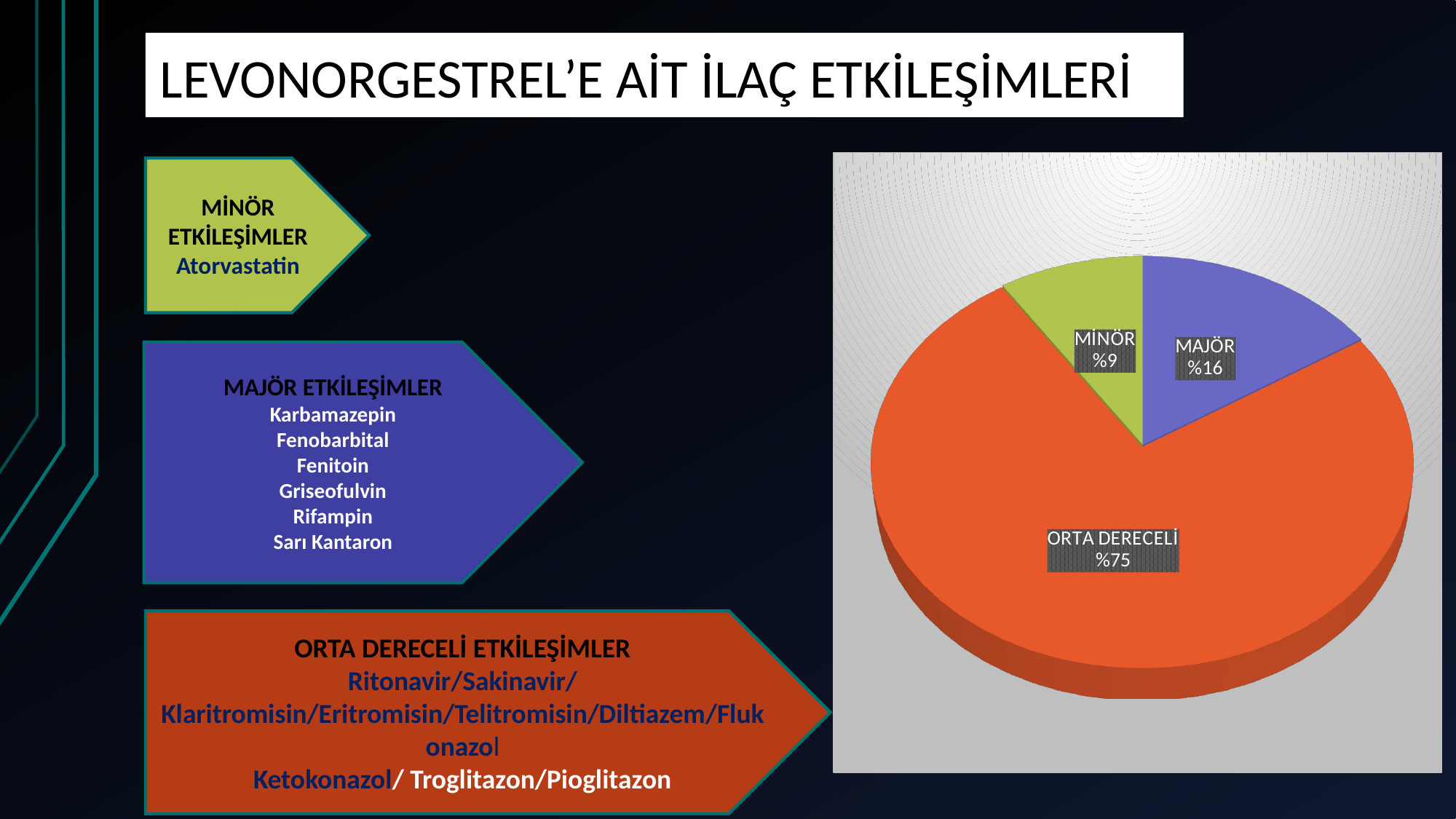
What colour is the ORTA DERECELİ slice of the pie chart? orange-red What is the value shown for the ORTA DERECELİ slice? %75 What is the value shown for the MİNÖR slice? %9 What kind of chart is shown on the slide? pie chart How many slices does the pie chart have? 3 What is the value shown for the MAJÖR slice? %16 Which slice of the pie chart is the smallest? MİNÖR What is the difference between the MAJÖR and MİNÖR values? %7 What is the difference between the ORTA DERECELİ and MAJÖR values? %59 Which is larger, the MAJÖR slice or the MİNÖR slice? MAJÖR Which slice of the pie chart is the largest? ORTA DERECELİ What colour is the MİNÖR slice of the pie chart? green